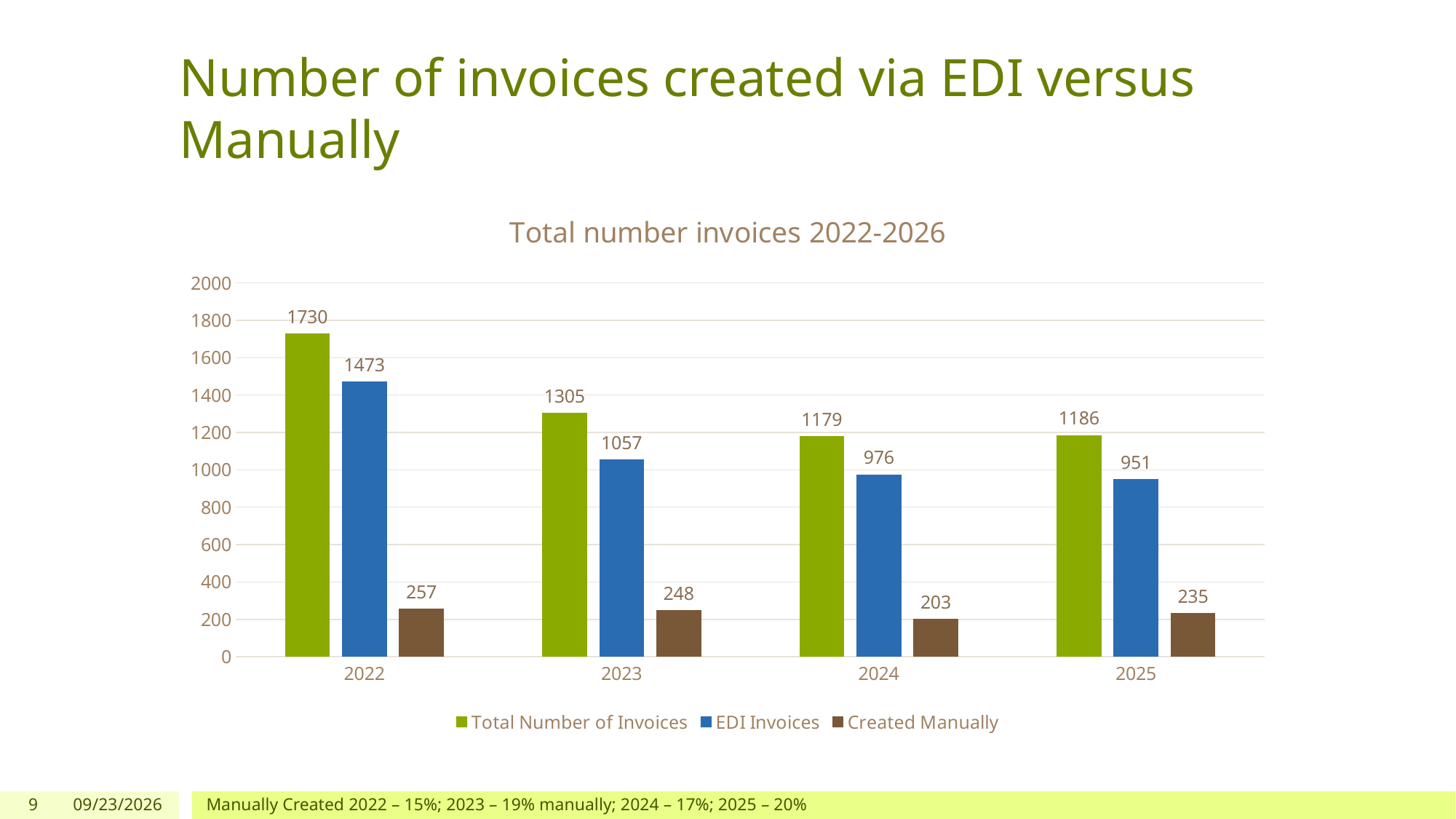
What is the title of the chart? Total number invoices 2022-2026 How many EDI Invoices were there in 2024? 976 What is the value for Created Manually in 2025? 235 What is the difference between the Total Number of Invoices and EDI Invoices in 2023? 248 What is the Total Number of Invoices for 2022? 1730 Is the value for EDI Invoices in 2022 greater or less than 1400? greater What kind of chart is shown on the slide? Bar chart Which is larger: EDI Invoices in 2023 or EDI Invoices in 2025? EDI Invoices in 2023 How many series does the legend list? 3 How many years are shown on the x axis? 4 Which year has the lowest value for Created Manually? 2024 Which year has the highest Total Number of Invoices? 2022